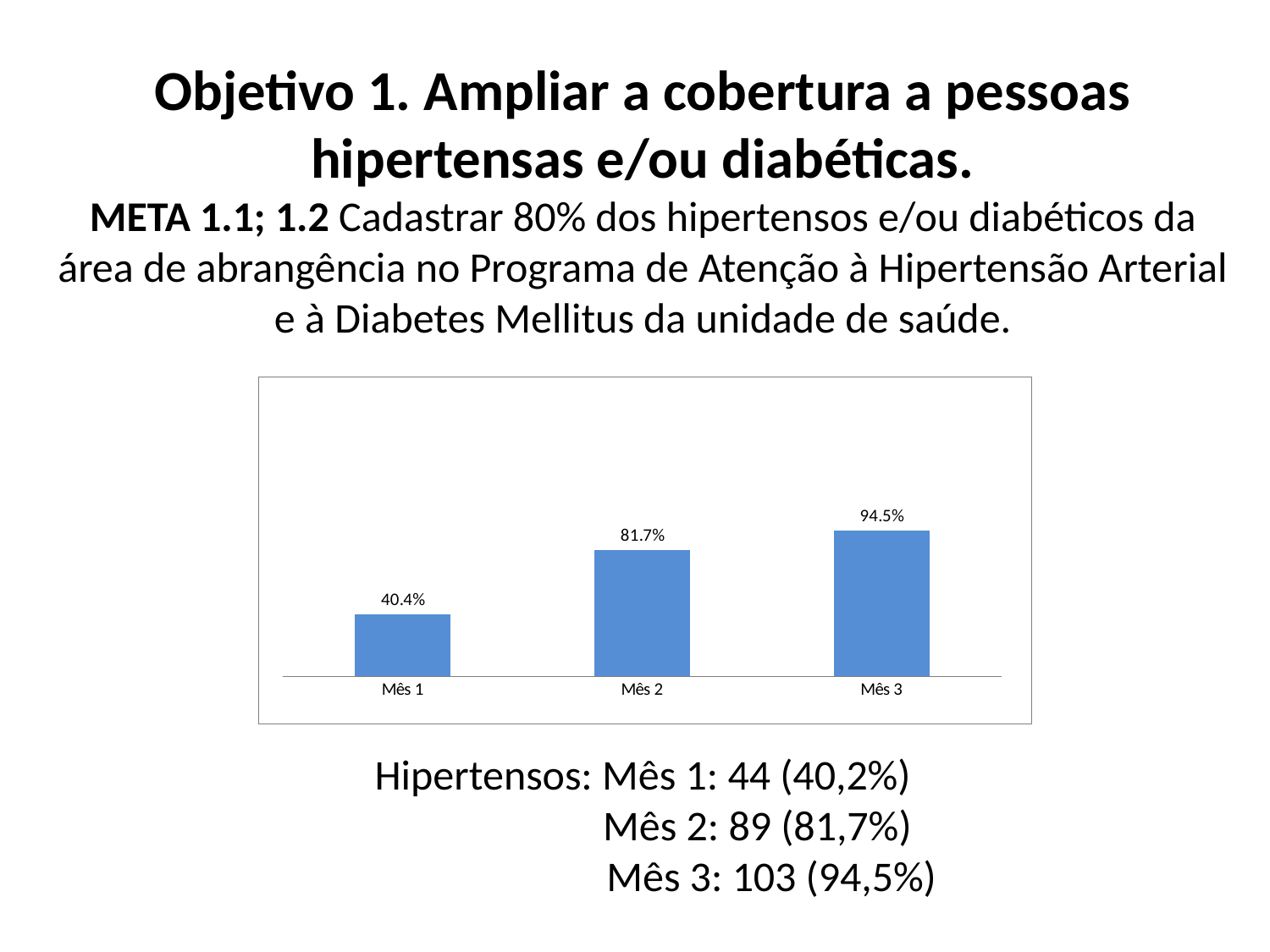
What is the difference between the values for Mês 2 and Mês 1? 41.3% Which is larger, the value for Mês 1 or the value for Mês 2? Mês 2 What is the difference between the values for Mês 3 and Mês 2? 12.8% What is the difference between the values for Mês 3 and Mês 1? 54.1% What is the value shown for Mês 3 in the bar chart? 94.5% What kind of chart is shown on the slide? Bar chart Do the values rise or fall from Mês 1 to Mês 3? Rise What is the value shown for Mês 1 in the bar chart? 40.4% How many categories are shown on the x axis of the bar chart? 3 Which month has the highest value in the bar chart? Mês 3 What is the value shown for Mês 2 in the bar chart? 81.7% Which month has the lowest value in the bar chart? Mês 1